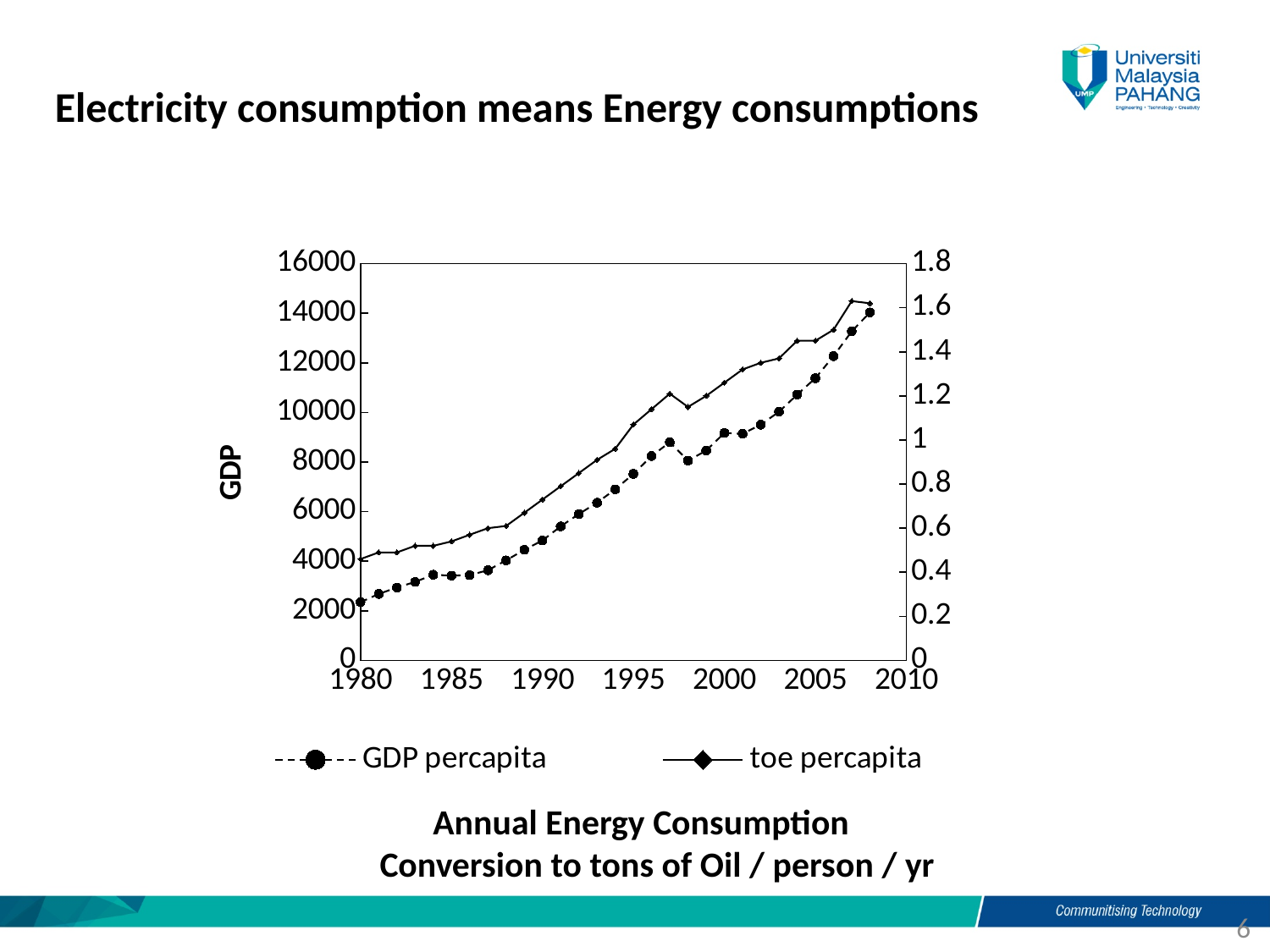
What kind of chart is shown on the slide? line chart Is the GDP percapita value for 2000 greater or less than 8000? greater What is the title of the left vertical axis? GDP Is the toe percapita value for 2005 greater or less than 1.2? greater Is the GDP percapita value for 1980 greater or less than 4000? less Does the GDP percapita series generally rise or fall from 1980 to 2008? rise Which is larger, the GDP percapita value for 2000 or for 1990? 2000 How many series does the legend list? 2 Does the toe percapita series generally rise or fall across the years shown? rise What are the two series named in the legend? GDP percapita and toe percapita